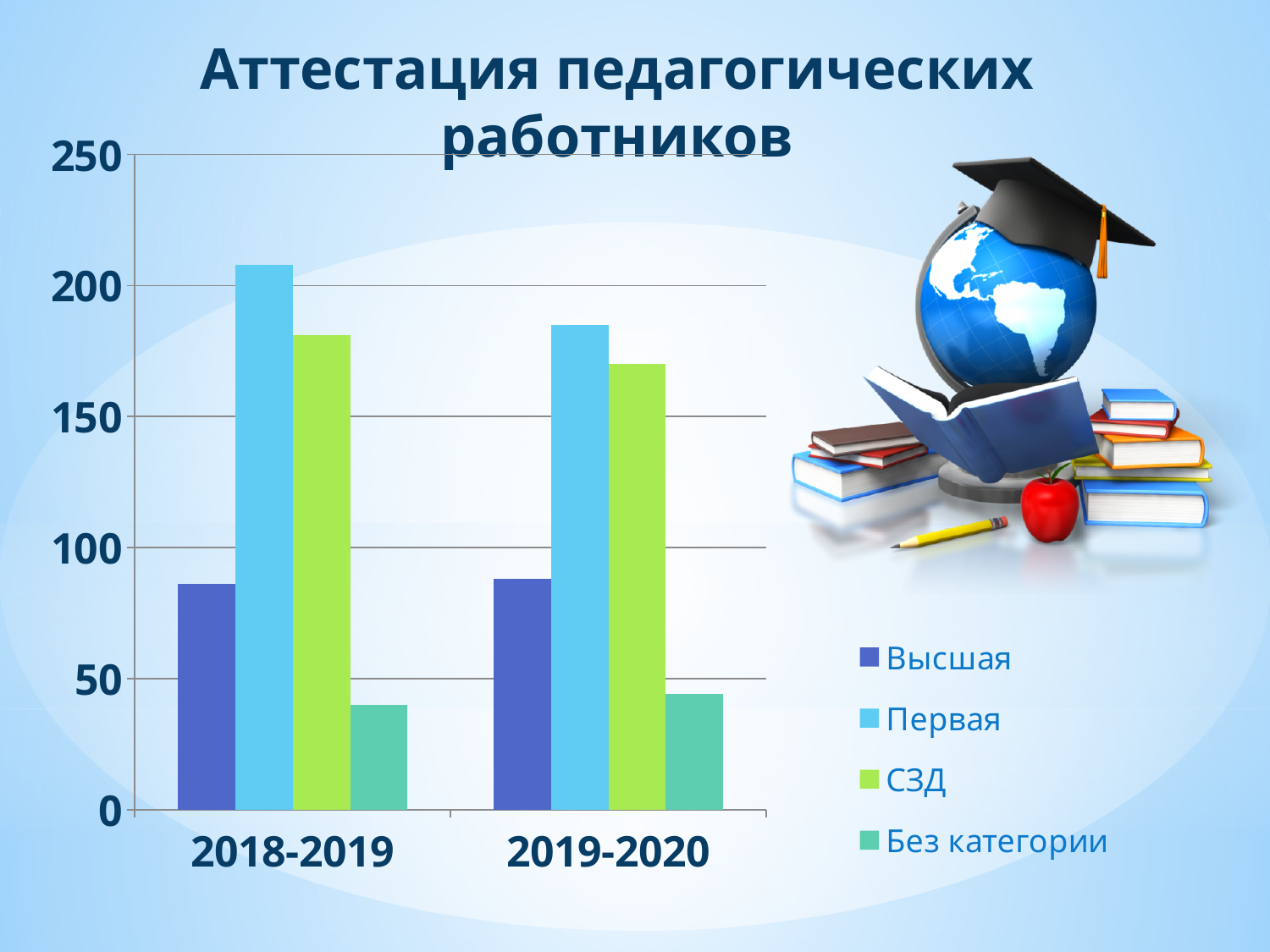
What is the title of the chart? Аттестация педагогических работников Which is larger: the value for Первая in 2018-2019 or in 2019-2020? 2018-2019 Is the value for СЗД in 2019-2020 greater or less than 150? greater Which series has the lowest value in 2019-2020? Без категории What kind of chart is shown on the slide? bar chart How many categories (academic years) are shown on the x axis? 2 Does the value for Первая rise or fall from 2018-2019 to 2019-2020? fall Is the value for Без категории in 2019-2020 greater or less than 50? less Is the value for Первая in 2018-2019 greater or less than 200? greater How many series does the legend list? 4 Which series has the highest value in 2018-2019? Первая